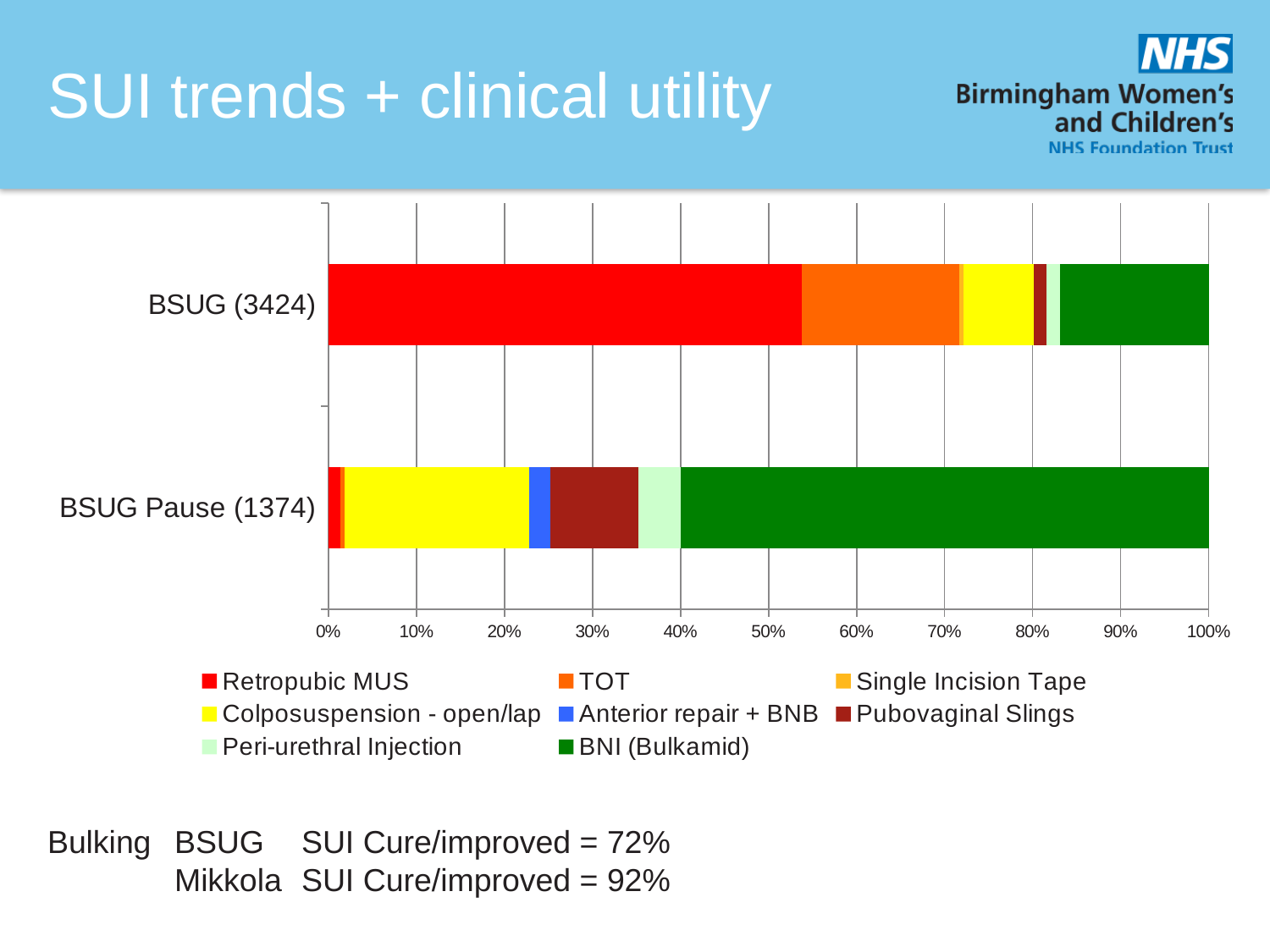
Which colour represents BNI (Bulkamid) in the legend? Dark green Is the Retropubic MUS share for BSUG Pause (1374) greater or less than 10%? less Which bar has the larger Colposuspension - open/lap share, BSUG (3424) or BSUG Pause (1374)? BSUG Pause (1374) What value does each stacked bar total on the x axis? 100% Is the BNI (Bulkamid) share for BSUG Pause (1374) greater or less than 50%? greater How many series does the legend list? 8 Which bar has the larger Retropubic MUS share, BSUG (3424) or BSUG Pause (1374)? BSUG (3424) What kind of chart is shown on the slide? Stacked bar chart Is the Retropubic MUS share for BSUG (3424) greater or less than 50%? greater Which series makes up the largest segment of the BSUG Pause (1374) bar? BNI (Bulkamid) How many categories (bars) does the chart show? 2 Which series makes up the largest segment of the BSUG (3424) bar? Retropubic MUS